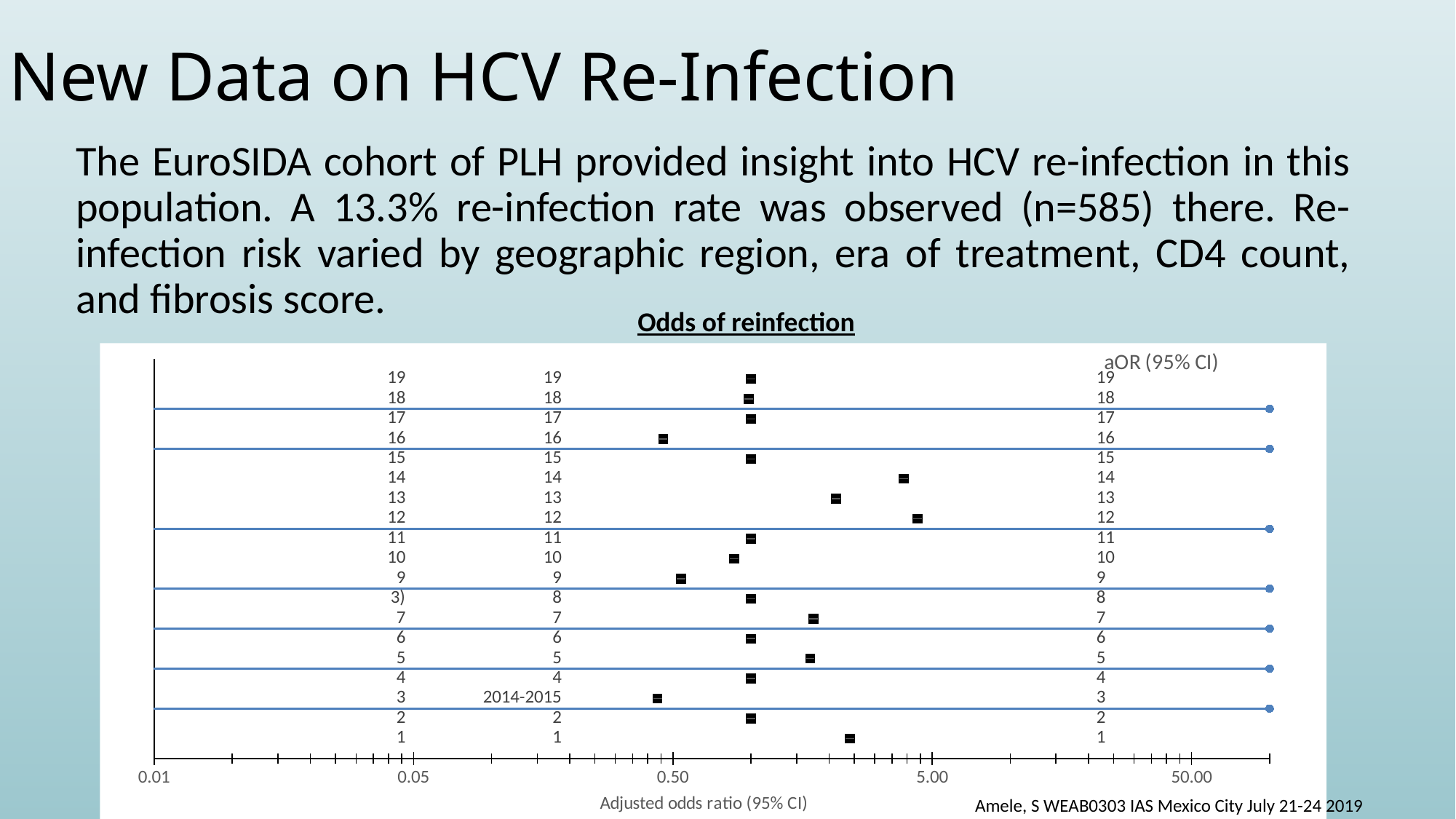
Which has the larger adjusted odds ratio, row 14 or row 16? Row 14 Is the adjusted odds ratio for row 1 greater or less than 0.50? greater What is the label of the x axis of the chart? Adjusted odds ratio (95% CI) Is the adjusted odds ratio for row 13 greater or less than 0.50? greater How many numbered rows (points) are plotted on the chart? 19 Which has the larger adjusted odds ratio, row 13 or row 9? Row 13 Which has the larger adjusted odds ratio, row 12 or row 1? Row 12 Is the adjusted odds ratio for row 14 greater or less than 0.50? greater What kind of chart is shown on the slide? Scatter chart (forest plot) What is the title of the chart on the slide? Odds of reinfection